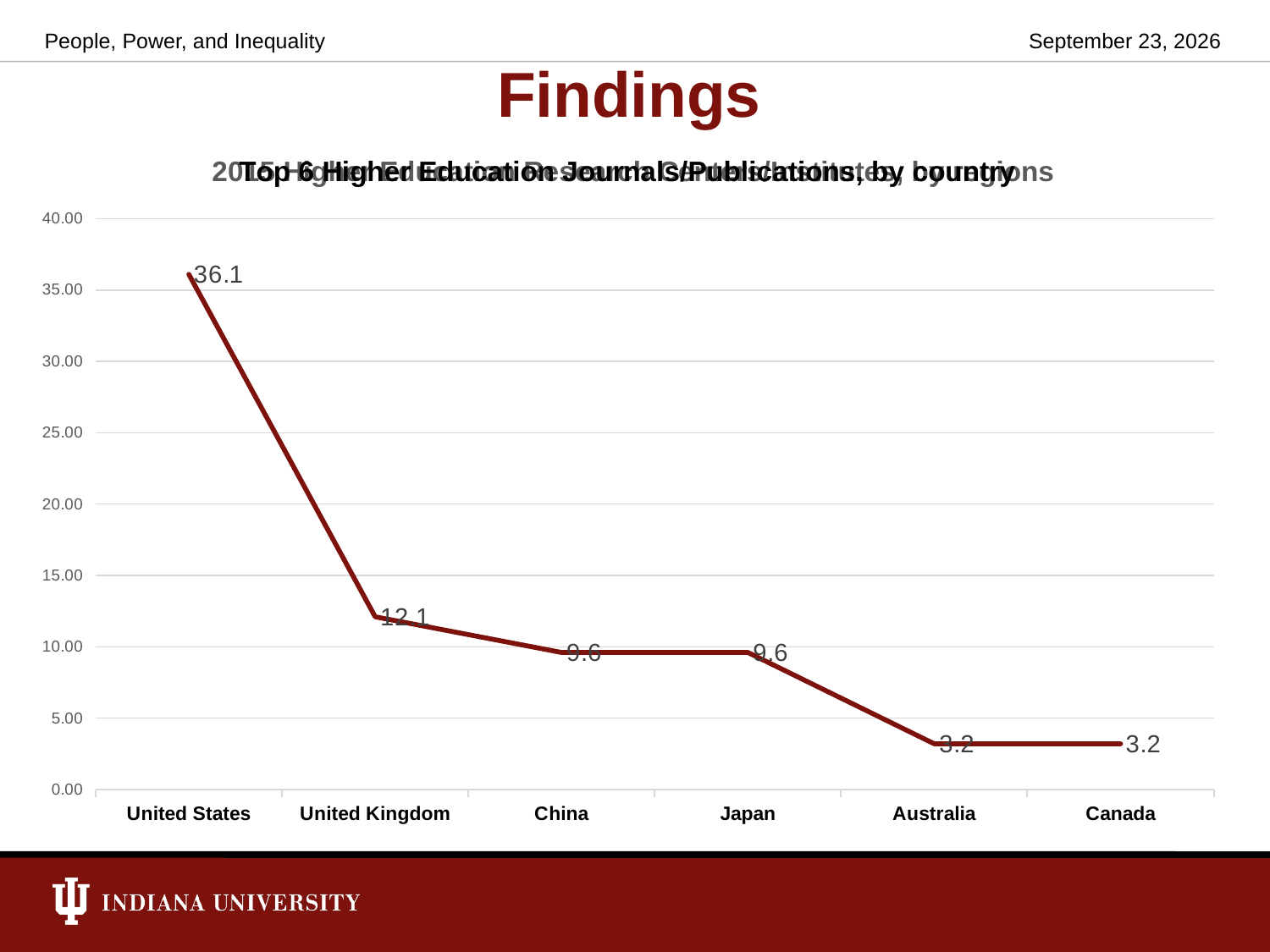
What is the difference between the values for Japan and Australia? 6.4 What kind of chart is shown on the slide? line chart Is the value for the United States greater or less than 35.00? greater What is the value for Canada? 3.2 Which country has the highest value? United States Which is larger, the value for the United Kingdom or the value for China? United Kingdom What is the value for China? 9.6 Which countries have the lowest value? Australia and Canada What is the value for the United Kingdom? 12.1 What is the difference between the values for the United States and the United Kingdom? 24.0 What is the value for the United States? 36.1 How many countries are shown on the x axis? 6